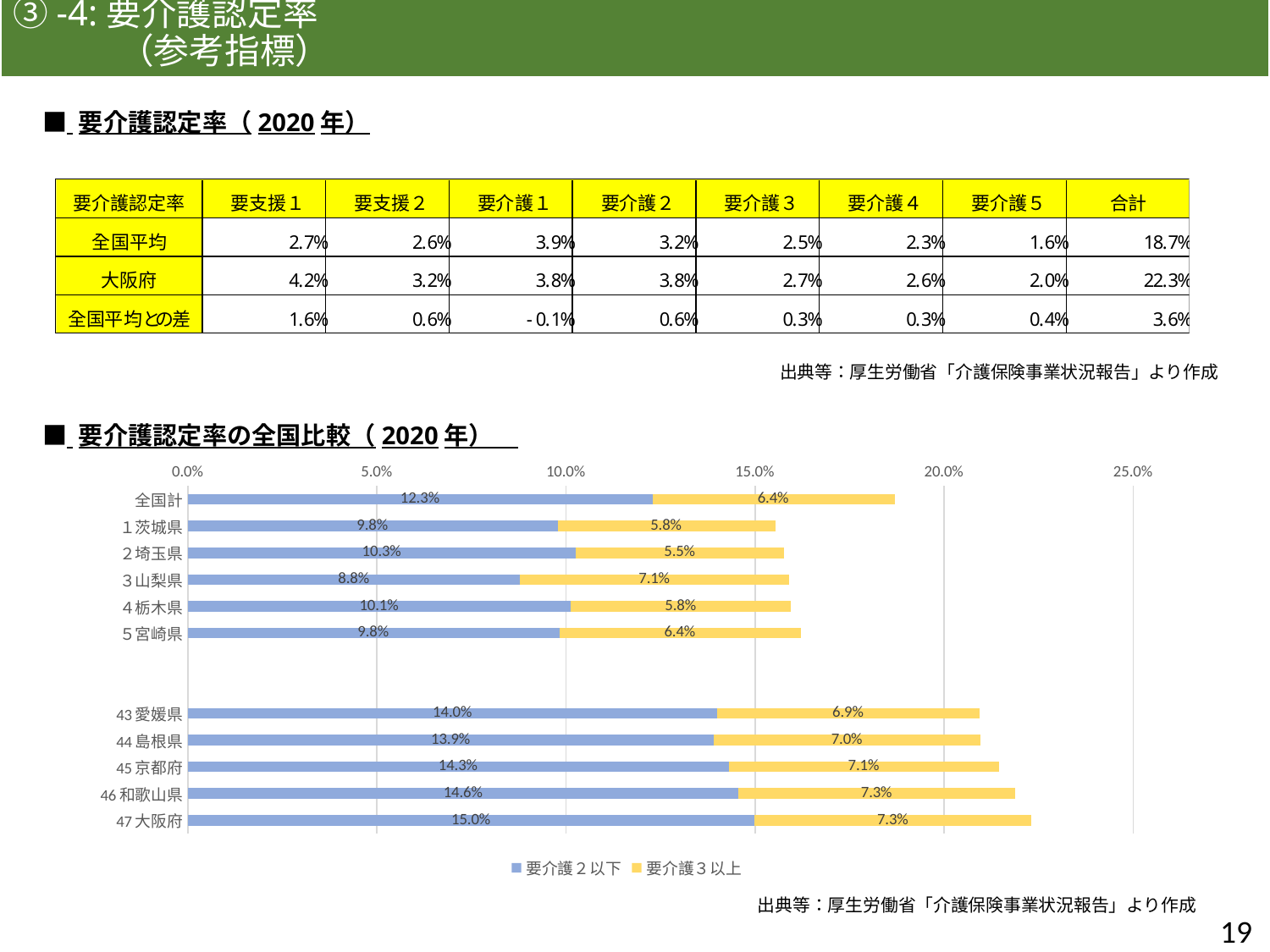
In the chart 要介護認定率の全国比較（2020年）, what is the total of the stacked bar for 47大阪府? 22.3% In the chart 要介護認定率の全国比較（2020年）, is the total bar length for 47大阪府 greater or less than 20.0%? greater In the chart 要介護認定率の全国比較（2020年）, which category has the lowest 要介護2以下 value? 3山梨県 In the chart 要介護認定率の全国比較（2020年）, what is the 要介護2以下 value for 47大阪府? 15.0% In the chart 要介護認定率の全国比較（2020年）, which has the larger 要介護3以上 value, 2埼玉県 or 5宮崎県? 5宮崎県 How many series does the legend of the chart 要介護認定率の全国比較（2020年） list? 2 How many categories are plotted in the chart 要介護認定率の全国比較（2020年）? 11 In the chart 要介護認定率の全国比較（2020年）, which category has the highest 要介護2以下 value? 47大阪府 In the chart 要介護認定率の全国比較（2020年）, what is the 要介護3以上 value for 3山梨県? 7.1% In the chart 要介護認定率の全国比較（2020年）, what is the difference between the 要介護2以下 values for 47大阪府 and 全国計? 2.7% In the chart 要介護認定率の全国比較（2020年）, what is the 要介護2以下 value for 全国計? 12.3% What kind of chart is 要介護認定率の全国比較（2020年）? Stacked bar chart